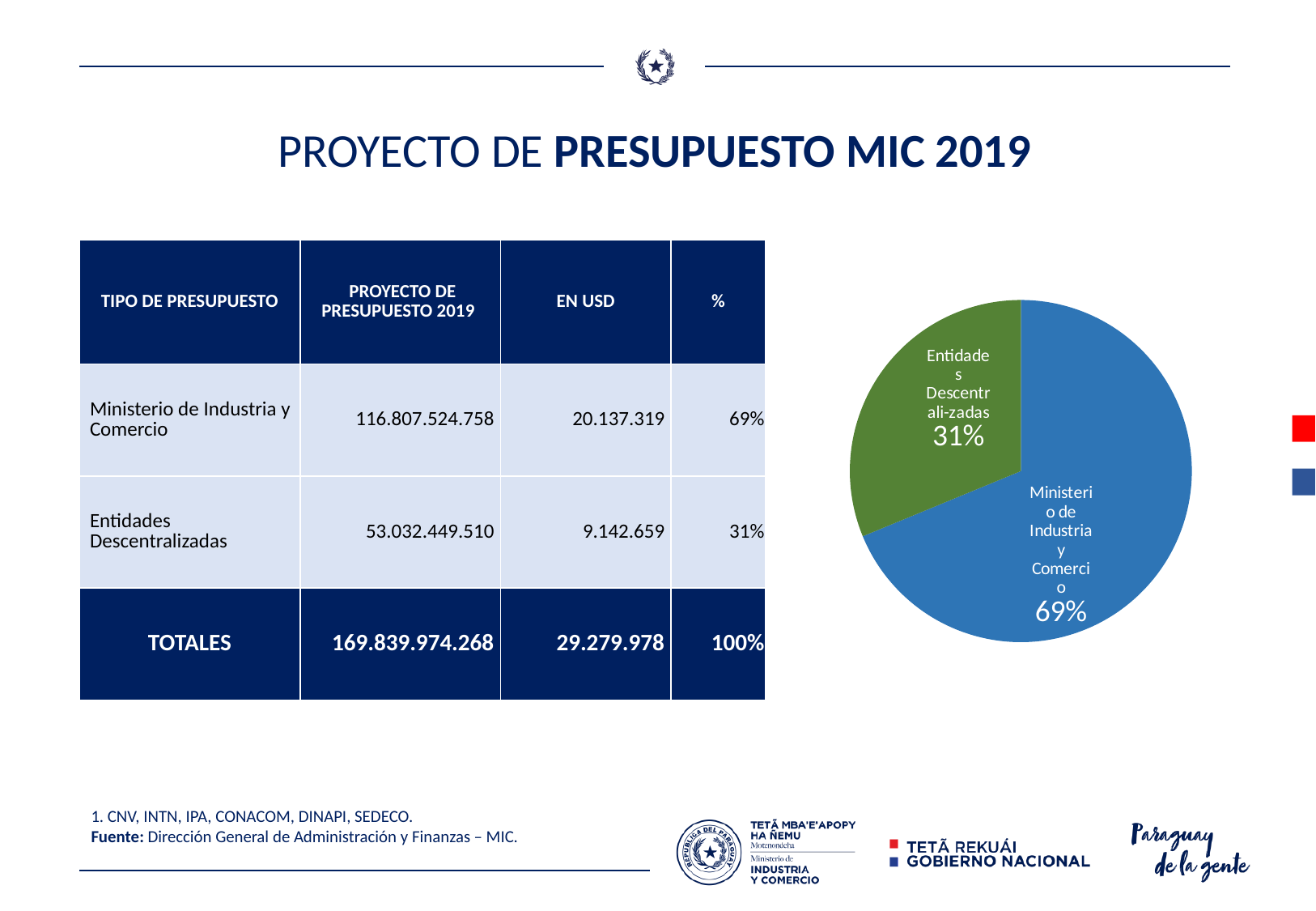
In the pie chart, which is larger: Ministerio de Industria y Comercio or Entidades Descentralizadas? Ministerio de Industria y Comercio What is the value labelled on the Entidades Descentralizadas slice of the pie chart? 31% What colour is the Ministerio de Industria y Comercio slice in the pie chart? blue Which slice of the pie chart is the largest? Ministerio de Industria y Comercio What colour is the Entidades Descentralizadas slice in the pie chart? green In the pie chart, what is the difference in percentage points between Ministerio de Industria y Comercio and Entidades Descentralizadas? 38 What share of the pie chart does Entidades Descentralizadas represent? 31% What do the two slices of the pie chart add up to? 100% Which slice of the pie chart is the smallest? Entidades Descentralizadas How many slices does the pie chart have? 2 What type of chart is shown on the slide? pie chart What share of the pie chart does Ministerio de Industria y Comercio represent? 69%